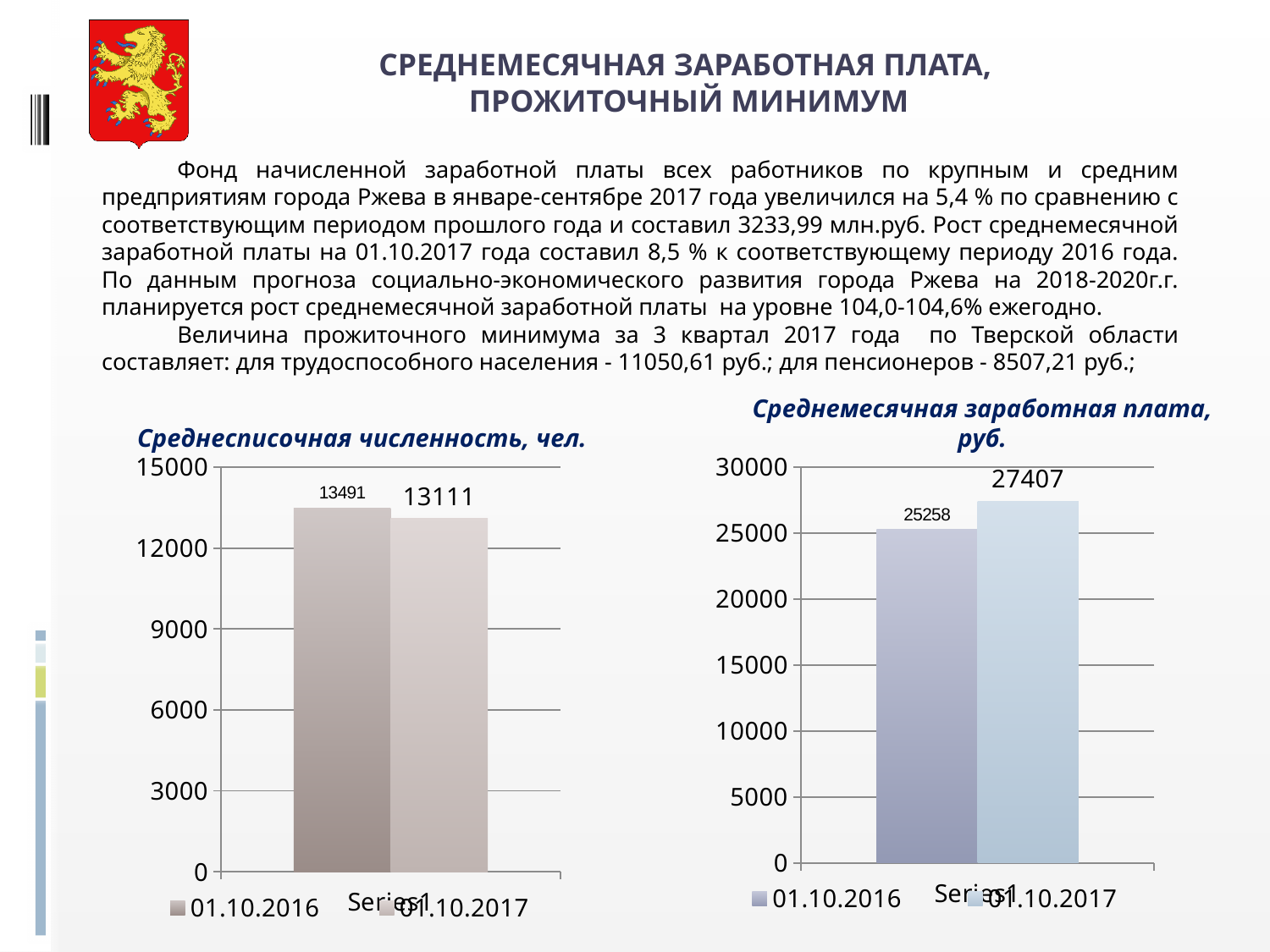
In the chart 'Среднесписочная численность, чел.', what is the difference between the 01.10.2016 and 01.10.2017 values? 380 In the chart 'Среднесписочная численность, чел.', what is the value for 01.10.2017? 13111 In the chart 'Среднемесячная заработная плата, руб.', what is the value for 01.10.2017? 27407 What is the title of the chart on the right side of the slide? Среднемесячная заработная плата, руб. In the chart 'Среднемесячная заработная плата, руб.', which series has the lower value? 01.10.2016 How many series does the legend of the chart 'Среднесписочная численность, чел.' list? 2 In the chart 'Среднемесячная заработная плата, руб.', what is the value for 01.10.2016? 25258 In the chart 'Среднемесячная заработная плата, руб.', is the value for 01.10.2017 greater or less than 25000? greater In the chart 'Среднесписочная численность, чел.', what is the value for 01.10.2016? 13491 What kind of chart is the chart 'Среднемесячная заработная плата, руб.'? bar chart In the chart 'Среднесписочная численность, чел.', which series has the higher value, 01.10.2016 or 01.10.2017? 01.10.2016 In the chart 'Среднемесячная заработная плата, руб.', by how much does the 01.10.2017 value exceed the 01.10.2016 value? 2149